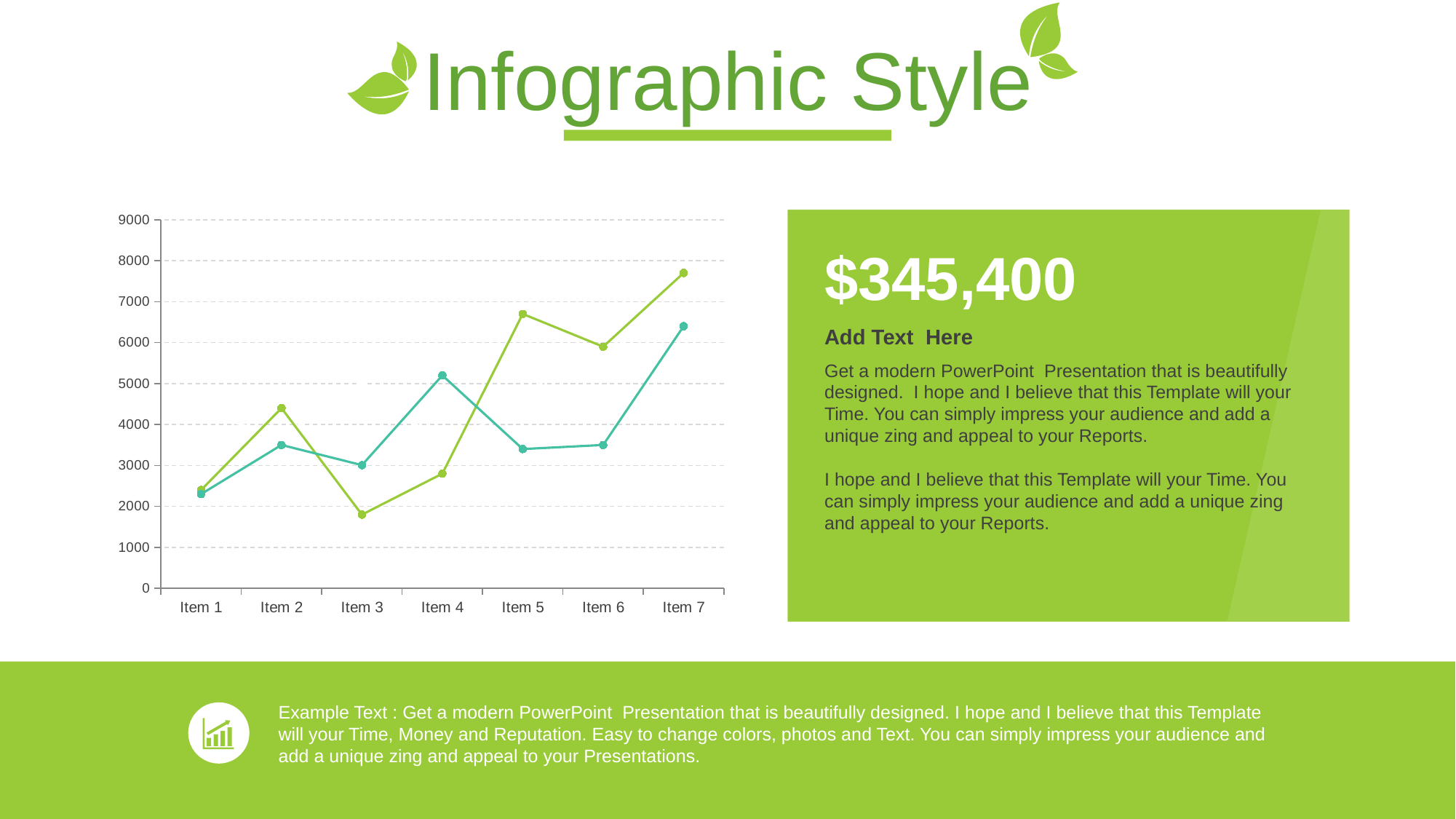
How many lines are plotted on the chart? 2 What kind of chart is shown on the slide? line chart Does the teal line rise or fall from Item 4 to Item 5? fall At which category does the light green line reach its lowest value? Item 3 Is the value of the teal line at Item 6 greater or less than 4000? less How many categories are shown on the x axis of the chart? 7 At which category does the teal line reach its highest value? Item 7 Is the value of the light green line at Item 7 greater or less than 7000? greater At Item 4, which line has the larger value, the light green line or the teal line? the teal line Is the value of the light green line at Item 3 greater or less than 2000? less At Item 5, which line has the larger value, the light green line or the teal line? the light green line At which category does the light green line reach its highest value? Item 7